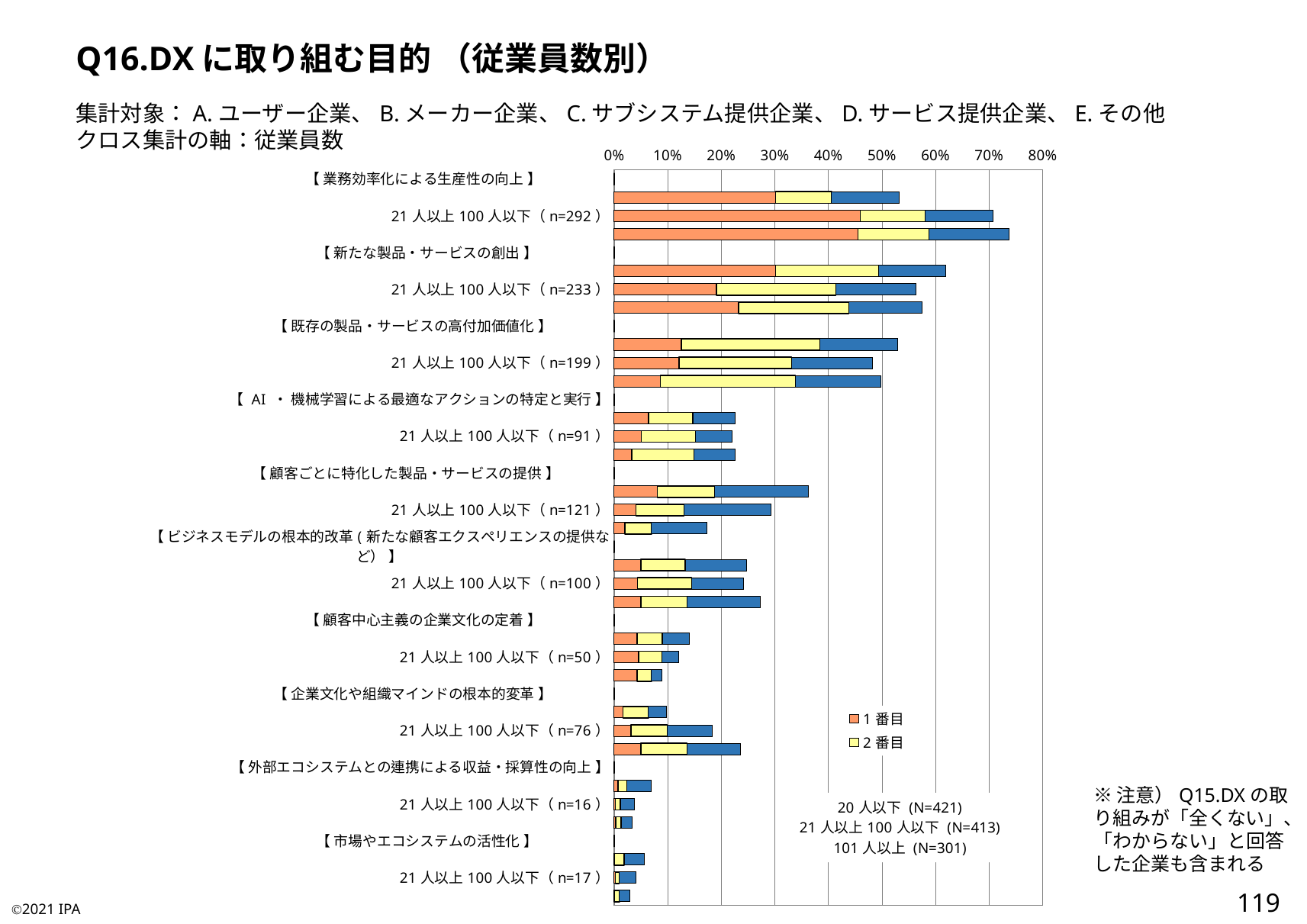
How many series does the chart's legend list? 2 How many purpose categories (bracketed headings) are shown on the chart? 10 Is the total stacked bar for 21 人以上 100 人以下 under 外部エコシステムとの連携による収益・採算性の向上 greater or less than 10%? less Is the total stacked bar for 21 人以上 100 人以下 under 業務効率化による生産性の向上 greater or less than 60%? greater What are the two entries shown in the chart's legend? 1 番目, 2 番目 For the 21 人以上 100 人以下 group, which has the longer total bar: 業務効率化による生産性の向上 or 新たな製品・サービスの創出? 業務効率化による生産性の向上 What kind of chart is shown on the slide? Stacked horizontal bar chart Is the total stacked bar for 21 人以上 100 人以下 under AI・機械学習による最適なアクションの特定と実行 greater or less than 30%? less Which purpose category has the longest stacked bar on the chart? 業務効率化による生産性の向上 What is the maximum value shown on the chart's horizontal axis? 80% What is the title of the slide's chart? Q16.DX に取り組む目的 （従業員数別）